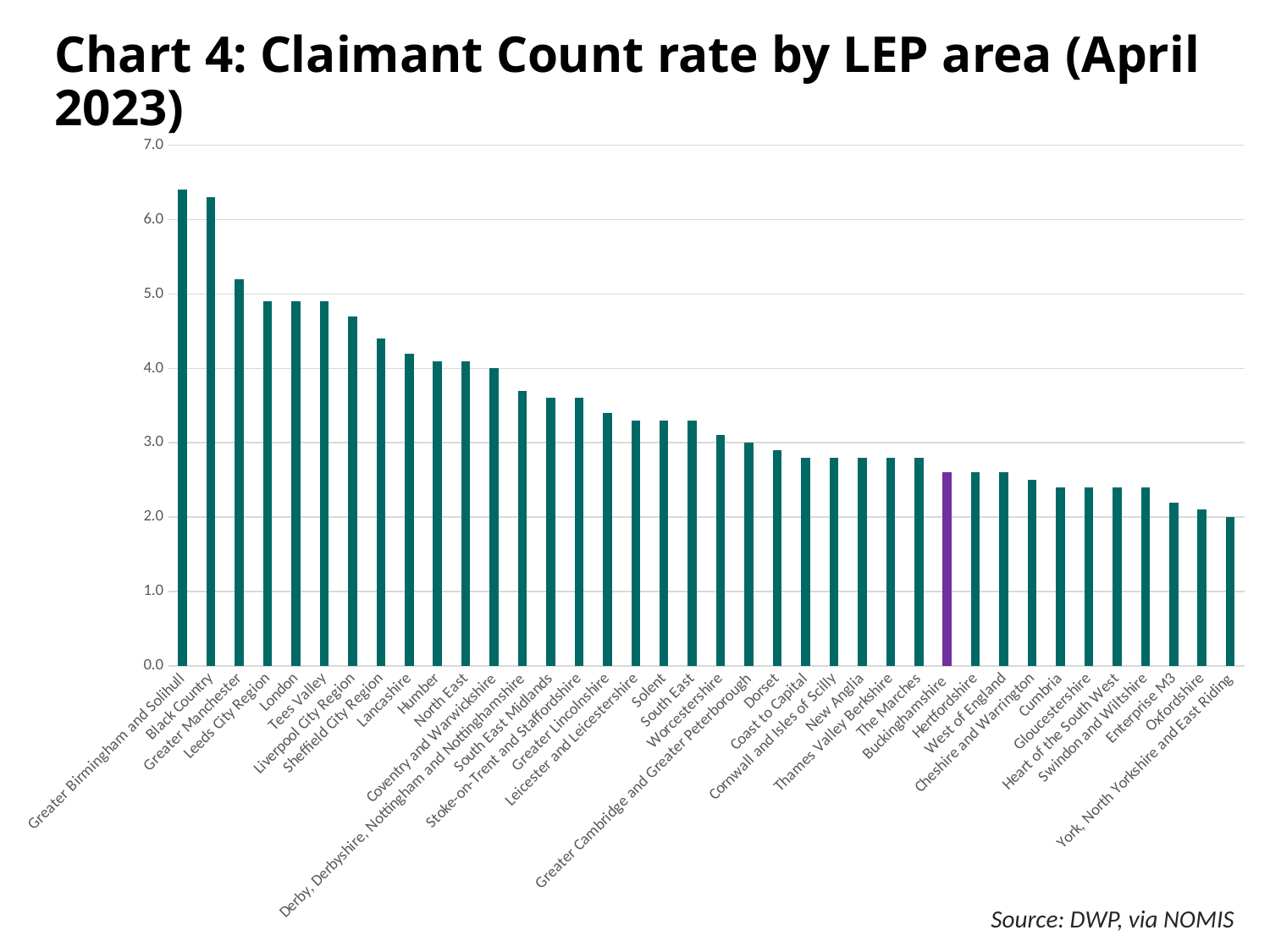
How many LEP areas are plotted in the chart? 38 Is the value for Lancashire greater or less than 4.0? greater What kind of chart is shown on the slide? bar chart Is the value for Buckinghamshire greater or less than 3.0? less Do the values rise or fall moving from left to right along the x axis? fall Which has the higher Claimant Count rate, London or Oxfordshire? London Which LEP area has the highest Claimant Count rate? Greater Birmingham and Solihull Is the value for Greater Manchester greater or less than 5.0? greater Which LEP area's bar is coloured purple rather than teal? Buckinghamshire Which has the higher Claimant Count rate, Black Country or Greater Manchester? Black Country